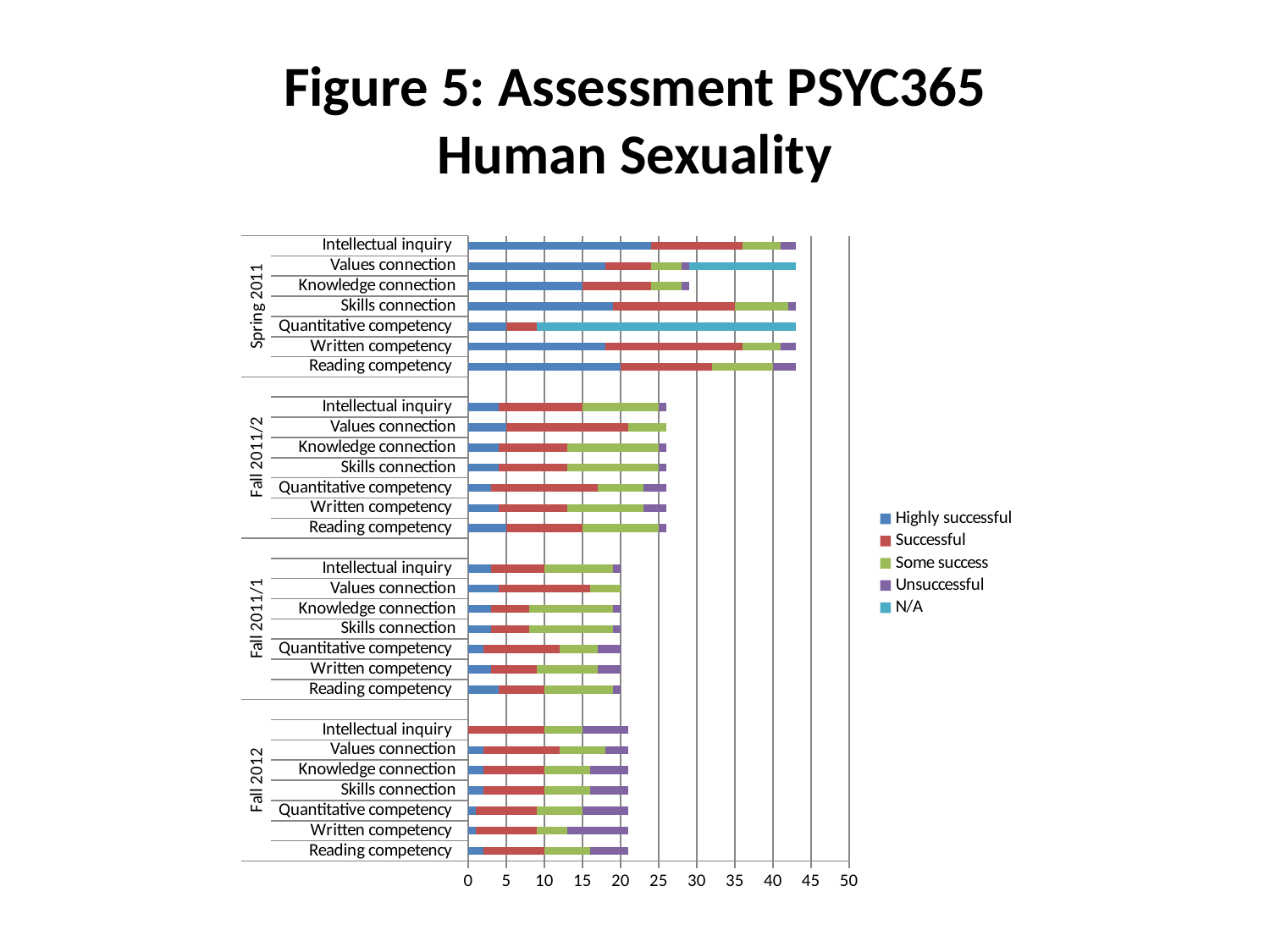
How many series does the legend list? 5 How many categories are listed under the Fall 2012 group? 7 Which is longer in total: the Intellectual inquiry bar for Spring 2011 or the Intellectual inquiry bar for Fall 2012? Spring 2011 Within Spring 2011, which category has the shortest Highly successful segment? Quantitative competency Is the total length of the Quantitative competency bar for Spring 2011 greater or less than 40? greater Which term group has the longest total bars overall? Spring 2011 Is the total length of the Knowledge connection bar for Spring 2011 greater or less than 30? less What kind of chart is shown on the slide? Stacked bar chart Is the Highly successful segment for Intellectual inquiry in Spring 2011 greater or less than 20? greater How many term groups (such as Spring 2011) are shown on the y axis? 4 Which series is listed last in the legend? N/A